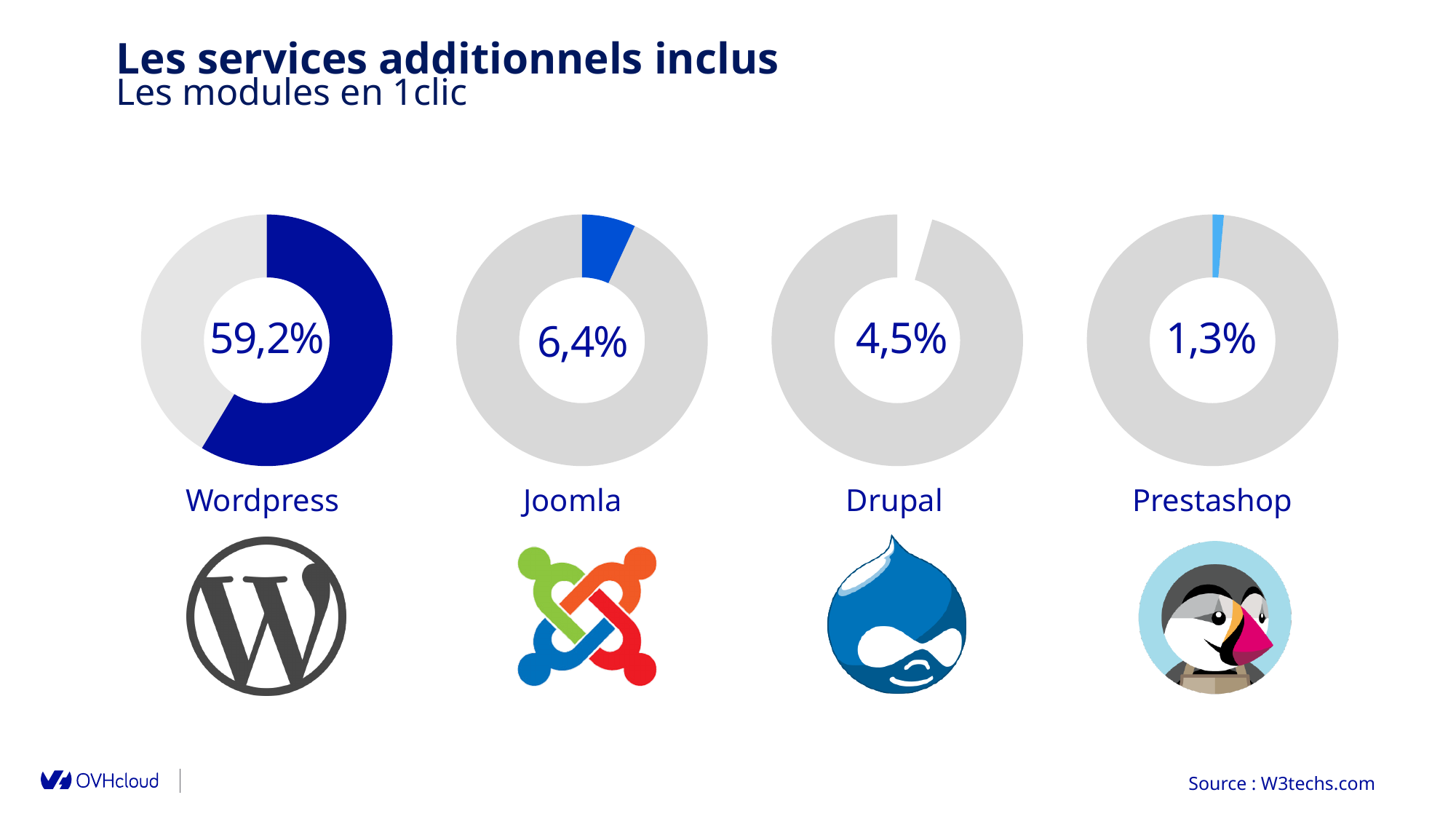
What source is cited for the data in the charts? W3techs.com What is the difference in percentage points between the Wordpress chart and the Joomla chart? 52,8 How many donut charts are shown on the slide? 4 Across the four donut charts, which platform has the highest percentage? Wordpress Across the four donut charts, which platform has the lowest percentage? Prestashop What percentage is shown in the Drupal donut chart? 4,5% Which has the larger percentage, the Joomla chart or the Drupal chart? Joomla What percentage is shown in the Joomla donut chart? 6,4% What percentage is shown in the Prestashop donut chart? 1,3% What percentage is shown in the Wordpress donut chart? 59,2% What is the difference in percentage points between the Drupal chart and the Prestashop chart? 3,2 What type of chart is used to show the Wordpress percentage? Donut (pie) chart